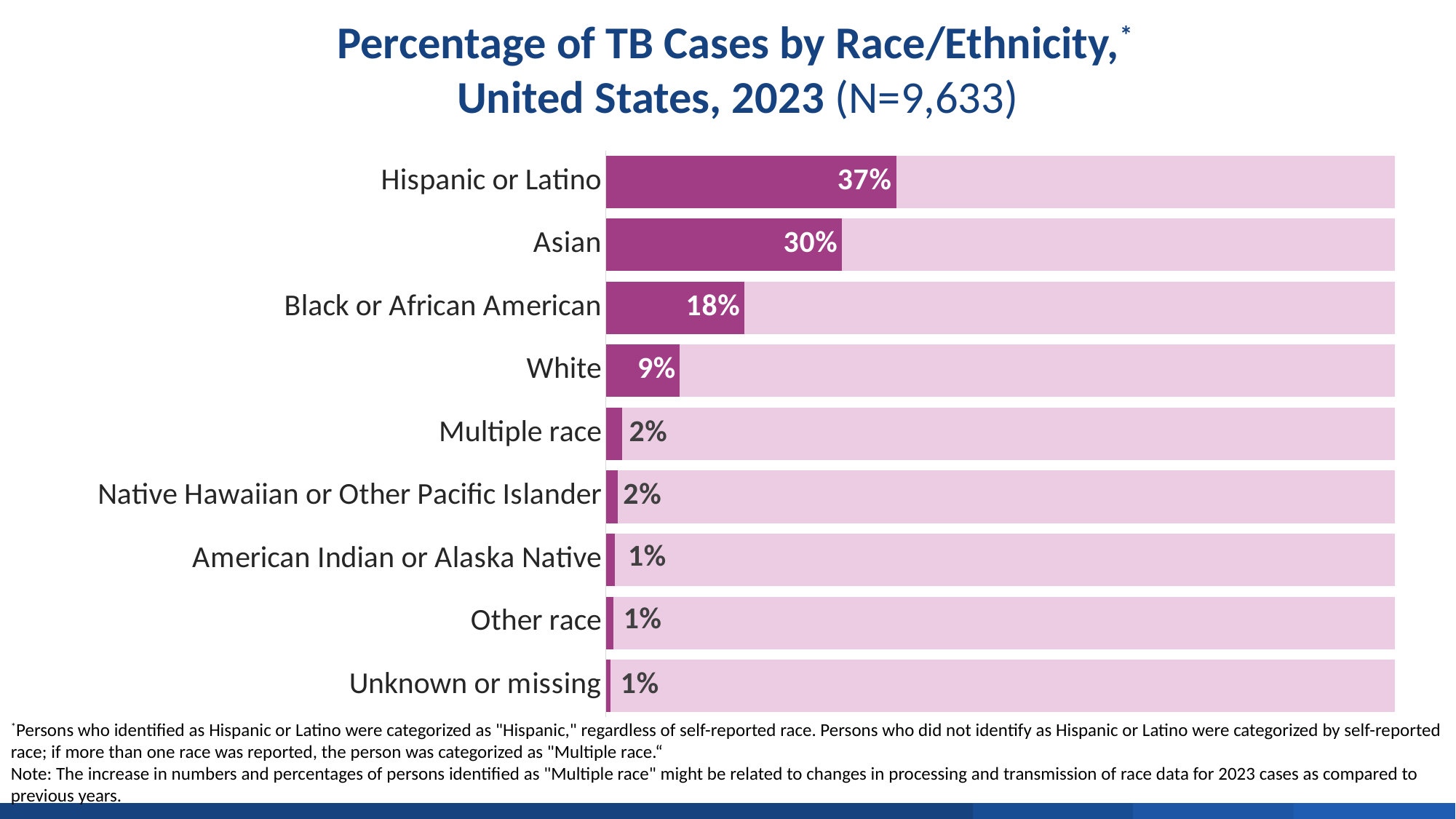
What percentage of TB cases were among Hispanic or Latino persons? 37% What is the difference in percentage points between the Hispanic or Latino and Asian categories? 7 What percentage of TB cases were among persons of Multiple race? 2% What kind of chart is shown on the slide? Bar chart What percentage of TB cases were among White persons? 9% What percentage of TB cases were among Black or African American persons? 18% How many race/ethnicity categories are shown in the chart? 9 What percentage of TB cases were among Asian persons? 30% What is the difference in percentage points between the Black or African American and White categories? 9 Which race/ethnicity category has the highest percentage of TB cases? Hispanic or Latino What is the total number of TB cases (N) given in the chart title? 9,633 Which is larger, the percentage for Asian or for Black or African American? Asian